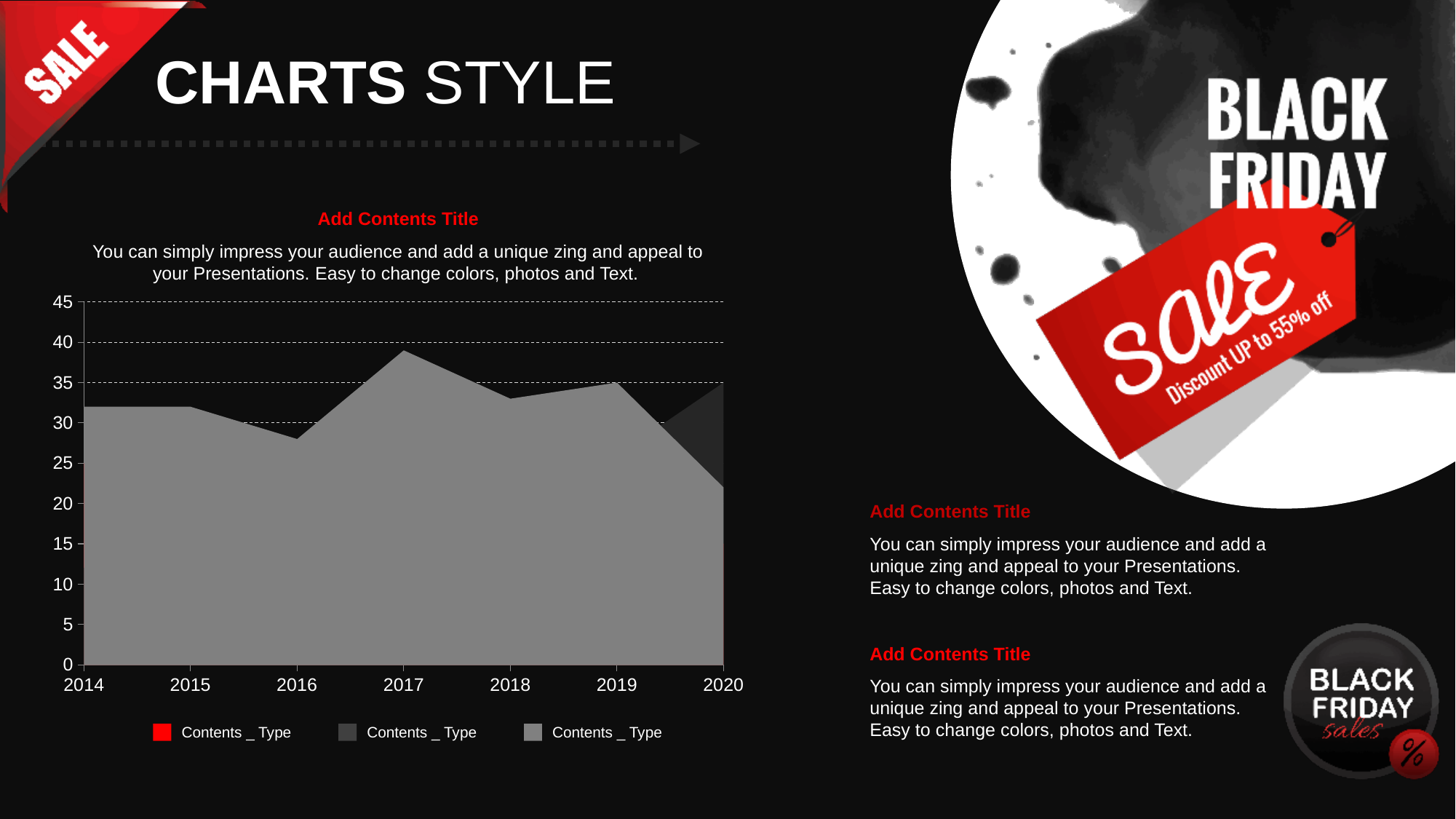
What kind of chart is shown on the slide? area chart What is the highest value shown on the chart's y axis? 45 Does the light gray series rise or fall from 2019 to 2020? fall In which year does the light gray series reach its highest value? 2017 Is the value of the light gray series in 2016 greater or less than 30? less How many years are shown along the x axis of the chart? 7 Is the value of the light gray series in 2020 greater or less than 25? less In which year does the light gray series reach its lowest value? 2020 Is the value of the light gray series in 2017 greater or less than 35? greater What is the first year shown on the chart's x axis? 2014 How many series does the chart's legend list? 3